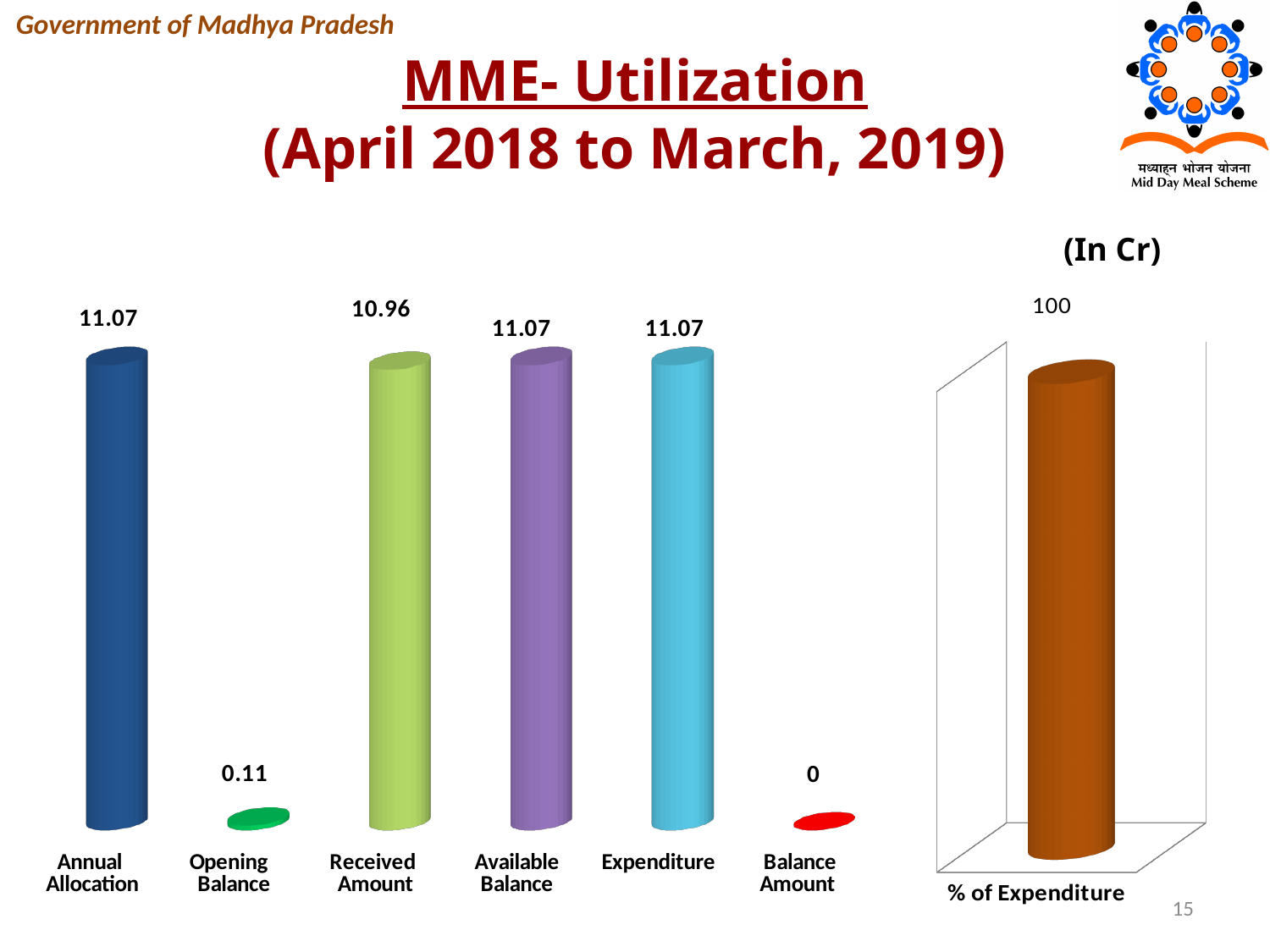
In the left chart, which is larger, Received Amount or Opening Balance? Received Amount In the left chart, what is the value for Annual Allocation? 11.07 How many categories are shown in the left chart? 6 In the left chart, what is the value for Balance Amount? 0 In the left chart, what is the value for Received Amount? 10.96 How many bars are shown in the right chart? 1 In the left chart, which category has the lowest value? Balance Amount In the left chart, what is the value for Opening Balance? 0.11 In the right chart, what is the value for % of Expenditure? 100 What kind of chart is the left chart? Bar chart In the left chart, what is the difference between Annual Allocation and Received Amount? 0.11 What unit is indicated for the values on the slide? In Cr